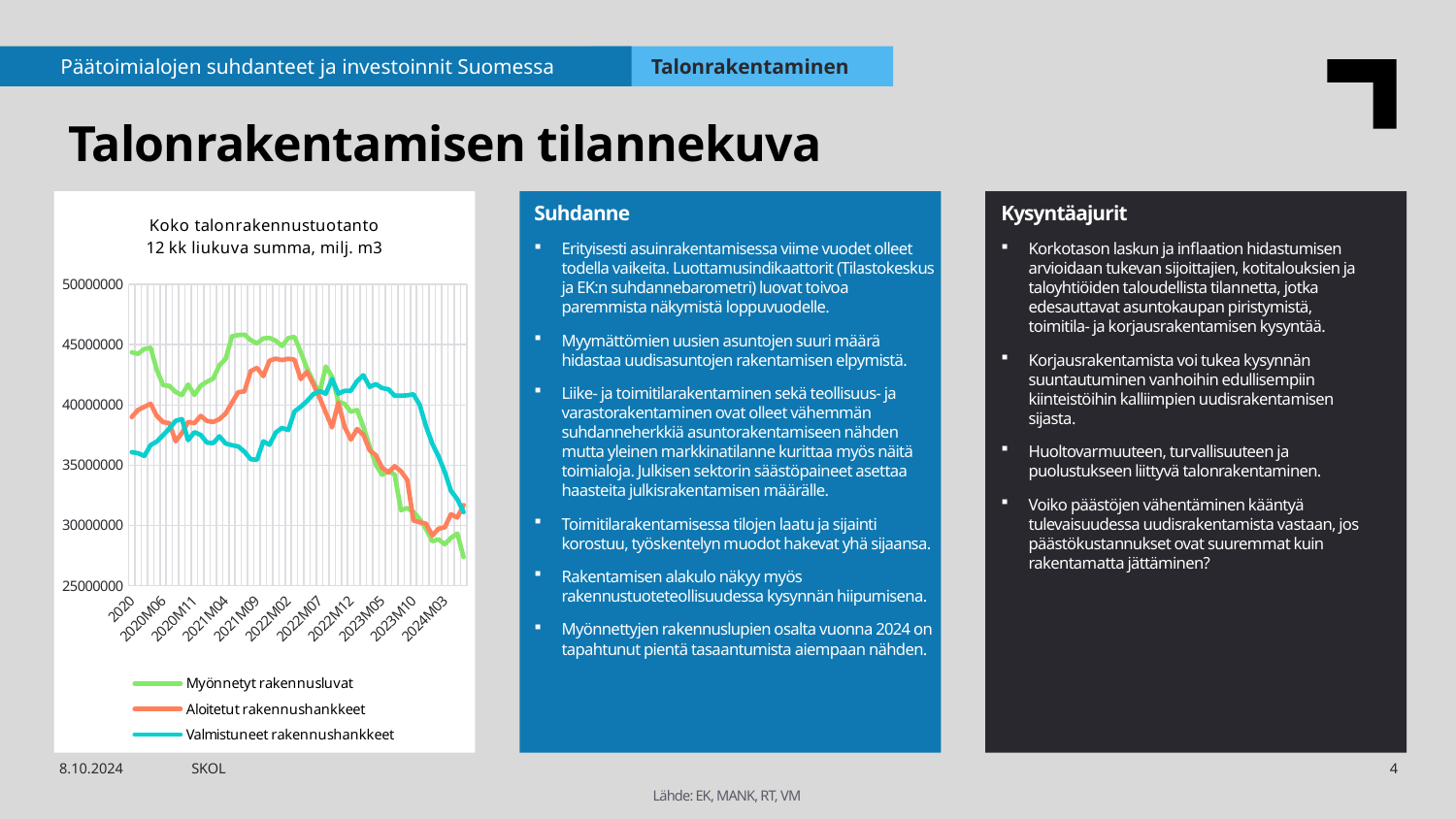
Is the value for Myönnetyt rakennusluvat at 2020 greater or less than 40000000? greater What is the title of the chart? Koko talonrakennustuotanto 12 kk liukuva summa, milj. m3 Which series is shown in green in the chart? Myönnetyt rakennusluvat Does the Myönnetyt rakennusluvat series rise or fall overall from 2020 to 2024M03? fall How many labels are shown on the x axis of the chart? 11 What kind of chart is shown on the slide? line chart Is the value for Valmistuneet rakennushankkeet at 2020 greater or less than 40000000? less Which series has the lowest value at 2020, the first point on the x axis? Valmistuneet rakennushankkeet At 2021M09, which is larger: Myönnetyt rakennusluvat or Valmistuneet rakennushankkeet? Myönnetyt rakennusluvat Which series has the highest value at 2020, the first point on the x axis? Myönnetyt rakennusluvat Is the value for Myönnetyt rakennusluvat at 2024M03 greater or less than 30000000? less How many series does the chart legend list? 3